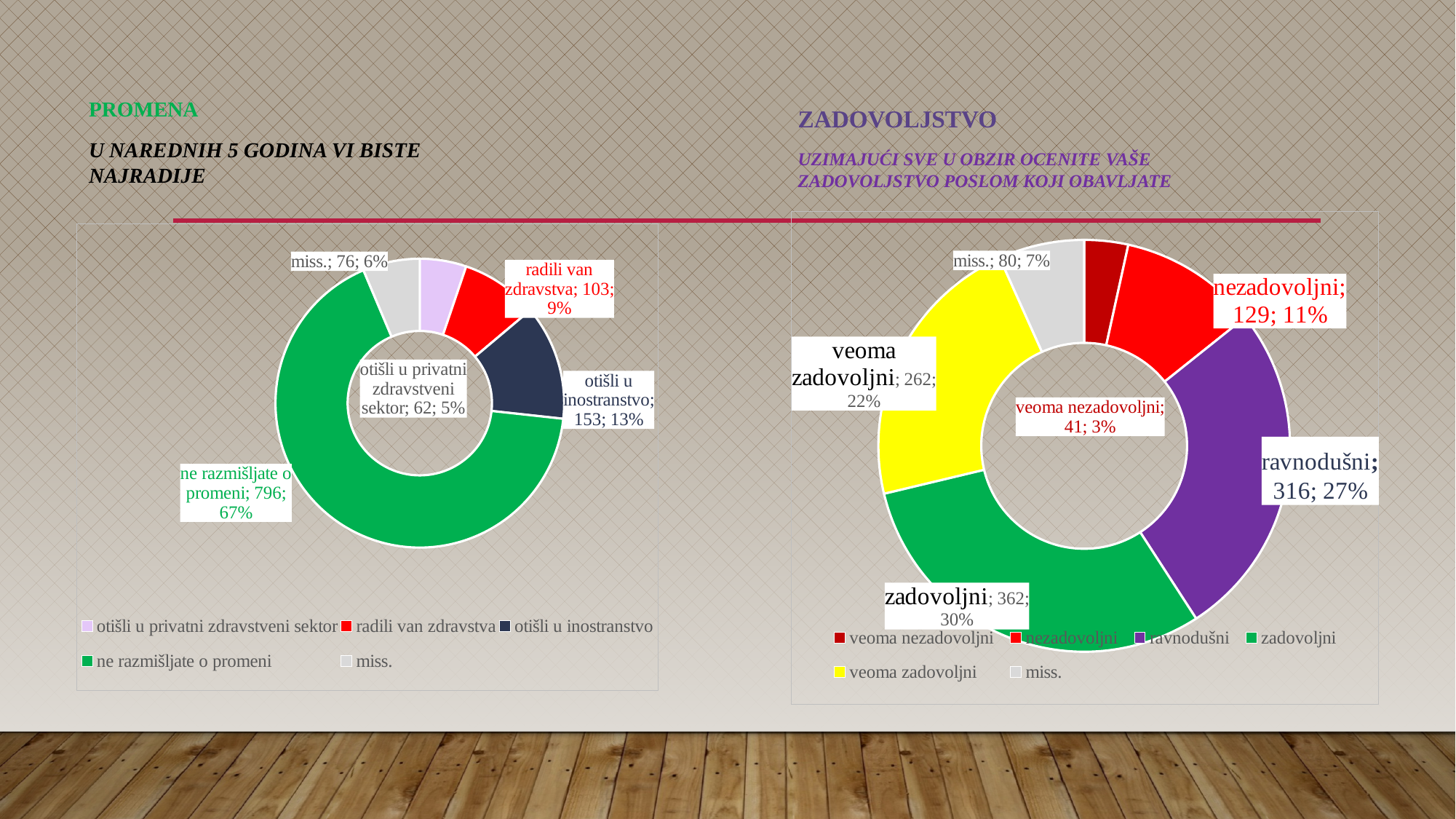
In the left chart (PROMENA), what is the difference between "otišli u inostranstvo" and "radili van zdravstva"? 50 In the left chart (PROMENA), what share of the total does "miss." represent? 6% In the left chart (PROMENA), how many categories does the legend list? 5 In the right chart (ZADOVOLJSTVO), what is the difference between "zadovoljni" and "ravnodušni"? 46 In the left chart (PROMENA), what is the value for "otišli u inostranstvo"? 153; 13% In the right chart (ZADOVOLJSTVO), which category has the largest value? zadovoljni In the right chart (ZADOVOLJSTVO), which category has the smallest value? veoma nezadovoljni In the right chart (ZADOVOLJSTVO), what is the value for "ravnodušni"? 316; 27% In the right chart (ZADOVOLJSTVO), which is larger: "veoma zadovoljni" or "nezadovoljni"? veoma zadovoljni What type of chart is used on the right side of the slide (ZADOVOLJSTVO)? Doughnut chart In the left chart (PROMENA), which category has the smallest value? otišli u privatni zdravstveni sektor In the left chart (PROMENA), what is the value for "ne razmišljate o promeni"? 796; 67%